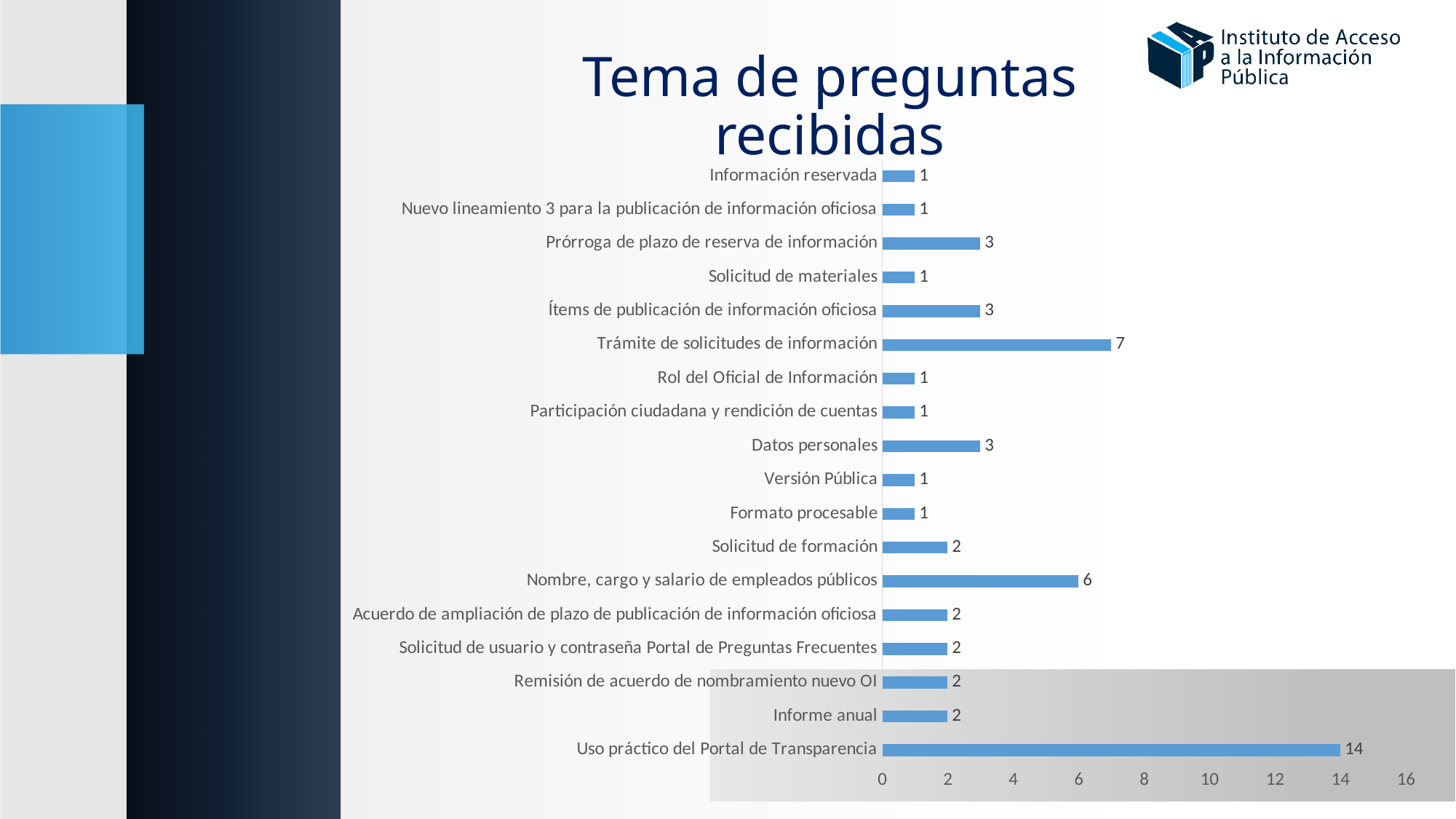
What is the value for Trámite de solicitudes de información? 7 Which is larger, the value for Prórroga de plazo de reserva de información or the value for Solicitud de materiales? Prórroga de plazo de reserva de información Which category has the highest value? Uso práctico del Portal de Transparencia How many categories are shown in the chart? 18 What is the difference between the values for Nombre, cargo y salario de empleados públicos and Solicitud de formación? 4 What is the value for Uso práctico del Portal de Transparencia? 14 What is the difference between the values for Uso práctico del Portal de Transparencia and Trámite de solicitudes de información? 7 What is the value for Informe anual? 2 What is the value for Nombre, cargo y salario de empleados públicos? 6 Is the value for Uso práctico del Portal de Transparencia greater or less than 10? greater What is the value for Datos personales? 3 What kind of chart is shown on the slide? Bar chart